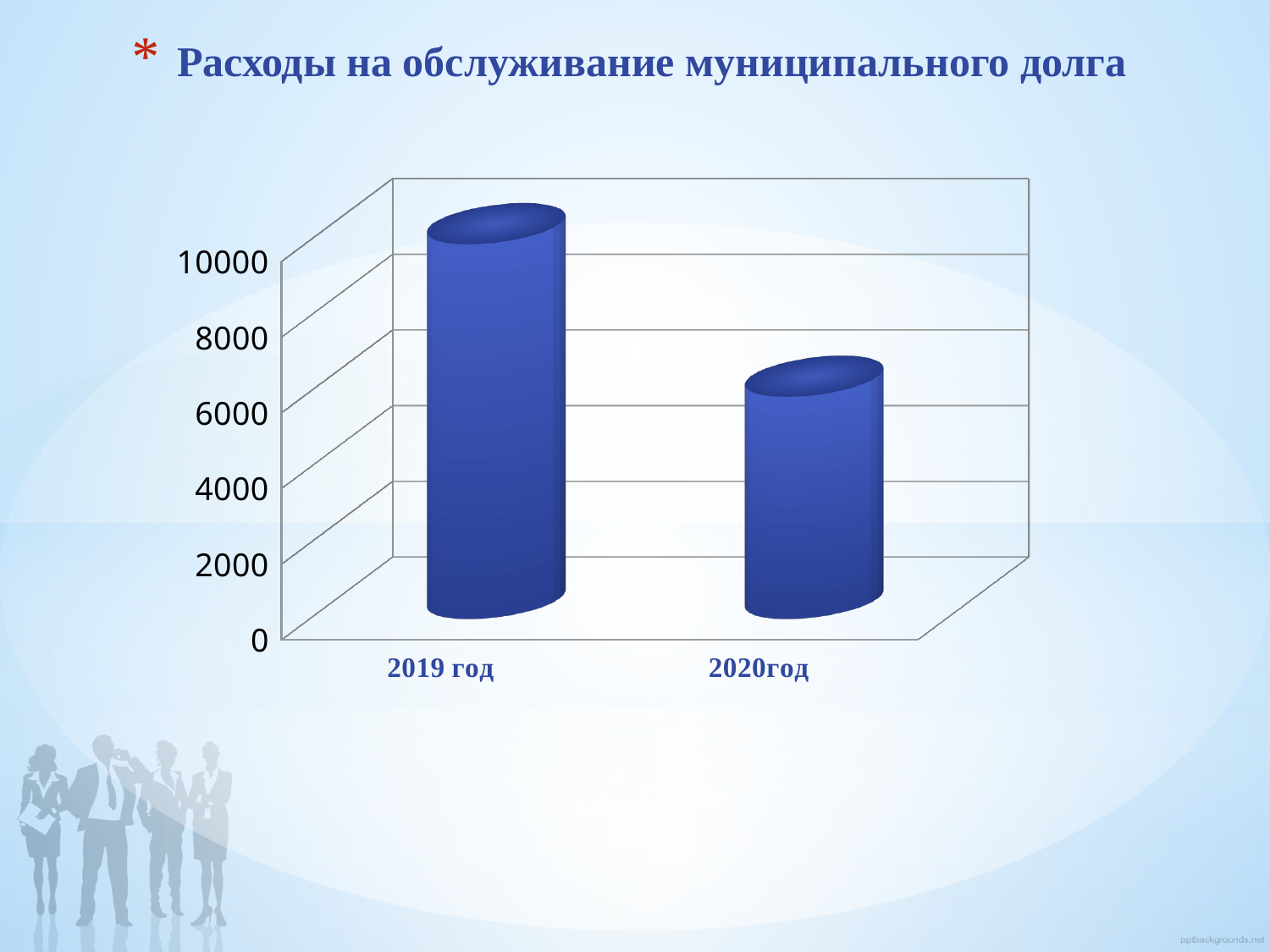
What kind of chart is shown on the slide? bar chart Is the value for 2019 год greater or less than 8000? greater Which category has the highest value in the chart? 2019 год Is the value for 2020год greater or less than 8000? less What is the title of the slide above the chart? Расходы на обслуживание муниципального долга How many categories are shown on the x axis of the chart? 2 Is the value for 2019 год greater or less than 6000? greater Which is larger, the value for 2019 год or the value for 2020год? 2019 год Do the values rise or fall from 2019 год to 2020год? fall What is the highest value labelled on the vertical axis of the chart? 10000 Which category has the lowest value in the chart? 2020год